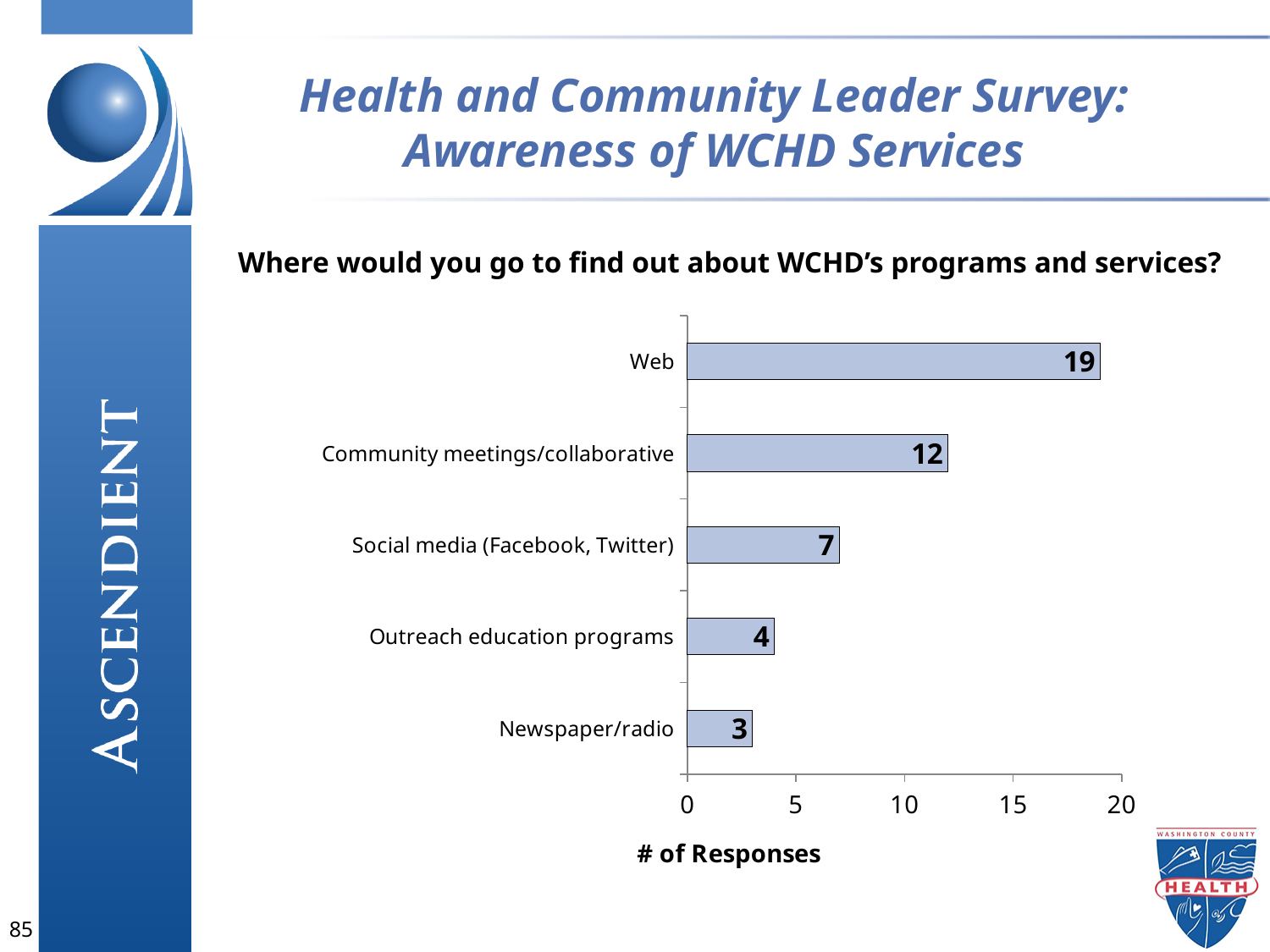
Which has more responses, Social media (Facebook, Twitter) or Outreach education programs? Social media (Facebook, Twitter) What is the difference in responses between Outreach education programs and Newspaper/radio? 1 What kind of chart is shown on the slide? Bar chart How many responses are shown for Web? 19 What is the difference in responses between Web and Community meetings/collaborative? 7 How many responses are shown for Social media (Facebook, Twitter)? 7 Which category has the lowest number of responses? Newspaper/radio How many responses are shown for Newspaper/radio? 3 How many responses are shown for Community meetings/collaborative? 12 How many categories are shown in the chart? 5 Which category has the highest number of responses? Web What is the label of the horizontal axis? # of Responses